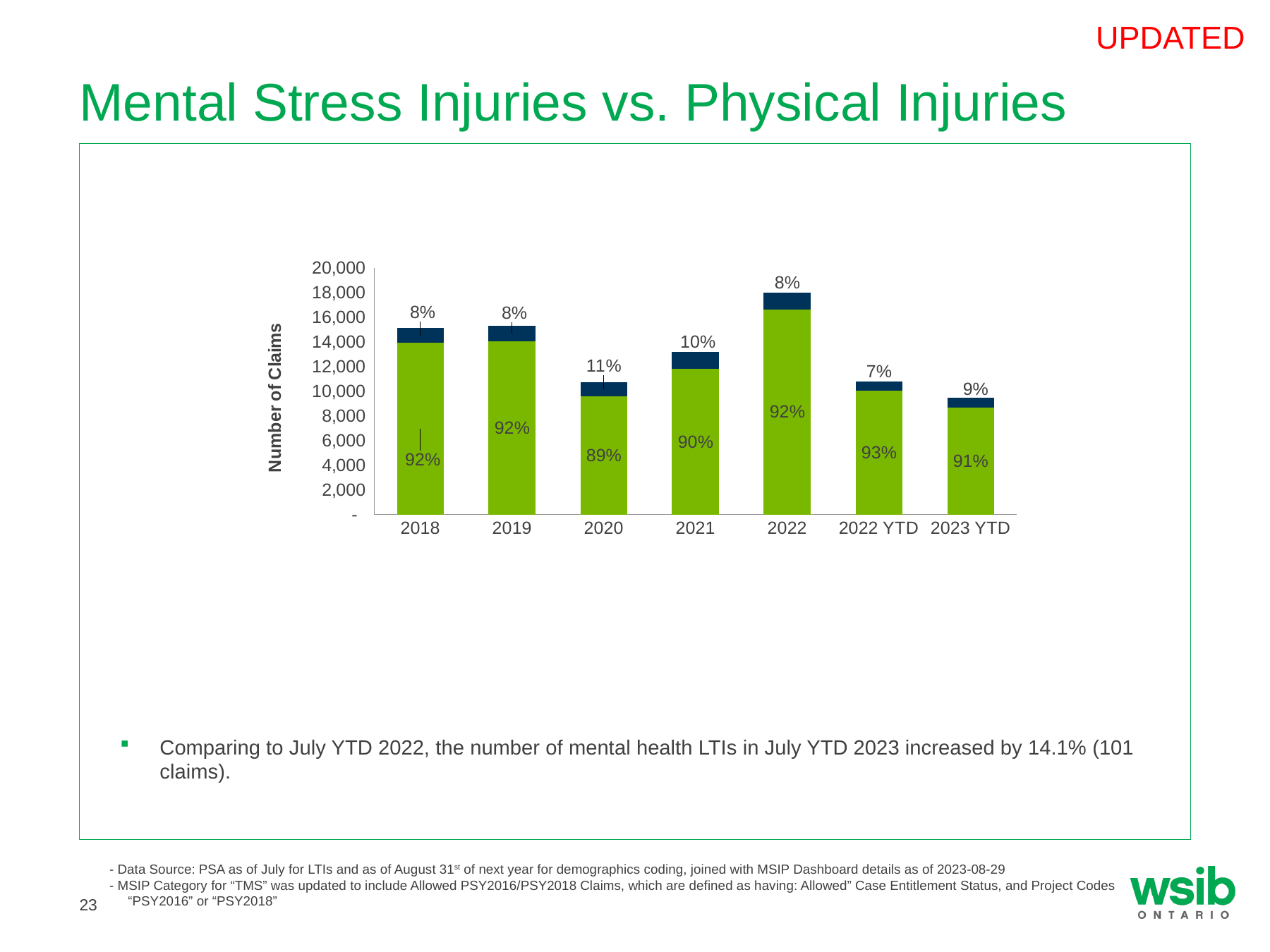
What is the title of the vertical axis? Number of Claims Which category has the highest percentage label above its bar (the dark blue segment)? 2020 Is the total height of the 2023 YTD bar greater or less than 10,000? less What kind of chart is shown on the slide? Stacked bar chart Which category has the lowest percentage label above its bar (the dark blue segment)? 2022 YTD Is the total height of the 2022 bar greater or less than 16,000? greater What is the difference in percentage points between the top label for 2020 and the top label for 2022 YTD? 4 percentage points What percentage label is shown above the 2021 bar? 10% What percentage label is shown on the green segment of the 2022 YTD bar? 93% What percentage label is shown on the green segment of the 2020 bar? 89% How many categories are shown on the x axis? 7 Which bar is taller in total, 2022 or 2020? 2022